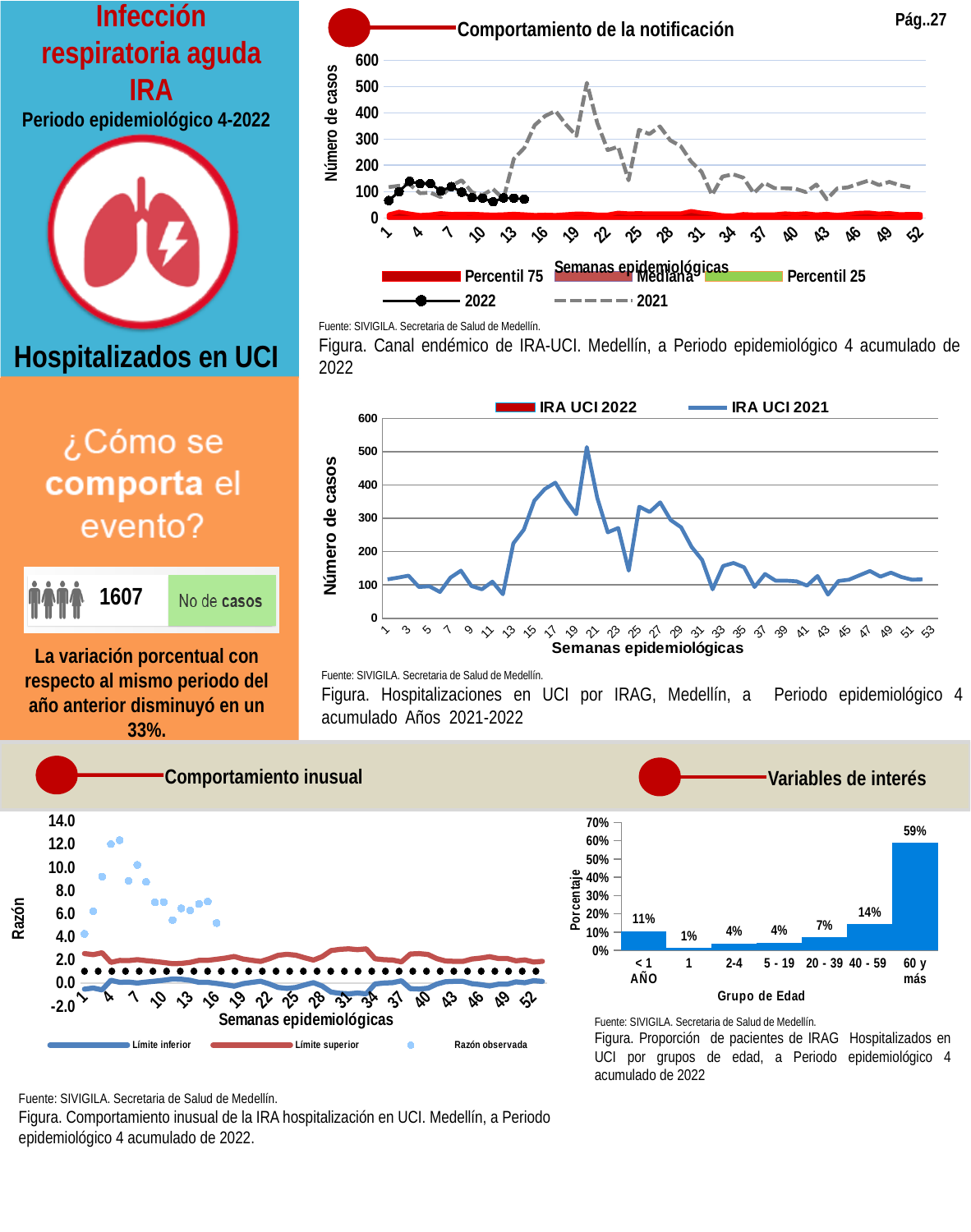
In the 'Variables de interés' bar chart, what percentage is shown for the '< 1 AÑO' age group? 11% How many age groups are shown in the 'Variables de interés' chart? 7 In the 'Variables de interés' bar chart, which age group has the lowest percentage? 1 What kind of chart is the 'Variables de interés' chart? Bar chart In the 'Variables de interés' bar chart, which age group has the highest percentage? 60 y más How many series does the legend of the 'Hospitalizaciones en UCI por IRAG' chart list? 2 In the 'Variables de interés' bar chart, what percentage is shown for the '40 - 59' age group? 14% In the 'Variables de interés' bar chart, what percentage is shown for the '60 y más' age group? 59% How many series does the legend of the 'Comportamiento de la notificación' (canal endémico) chart list? 5 In the 'Variables de interés' bar chart, what is the difference in percentage points between the '60 y más' and '40 - 59' groups? 45 percentage points In the 'Hospitalizaciones en UCI por IRAG' chart, is the peak value of IRA UCI 2021 around week 20 greater or less than 400? greater In the 'Variables de interés' bar chart, which has a larger percentage: the '20 - 39' group or the '5 - 19' group? 20 - 39